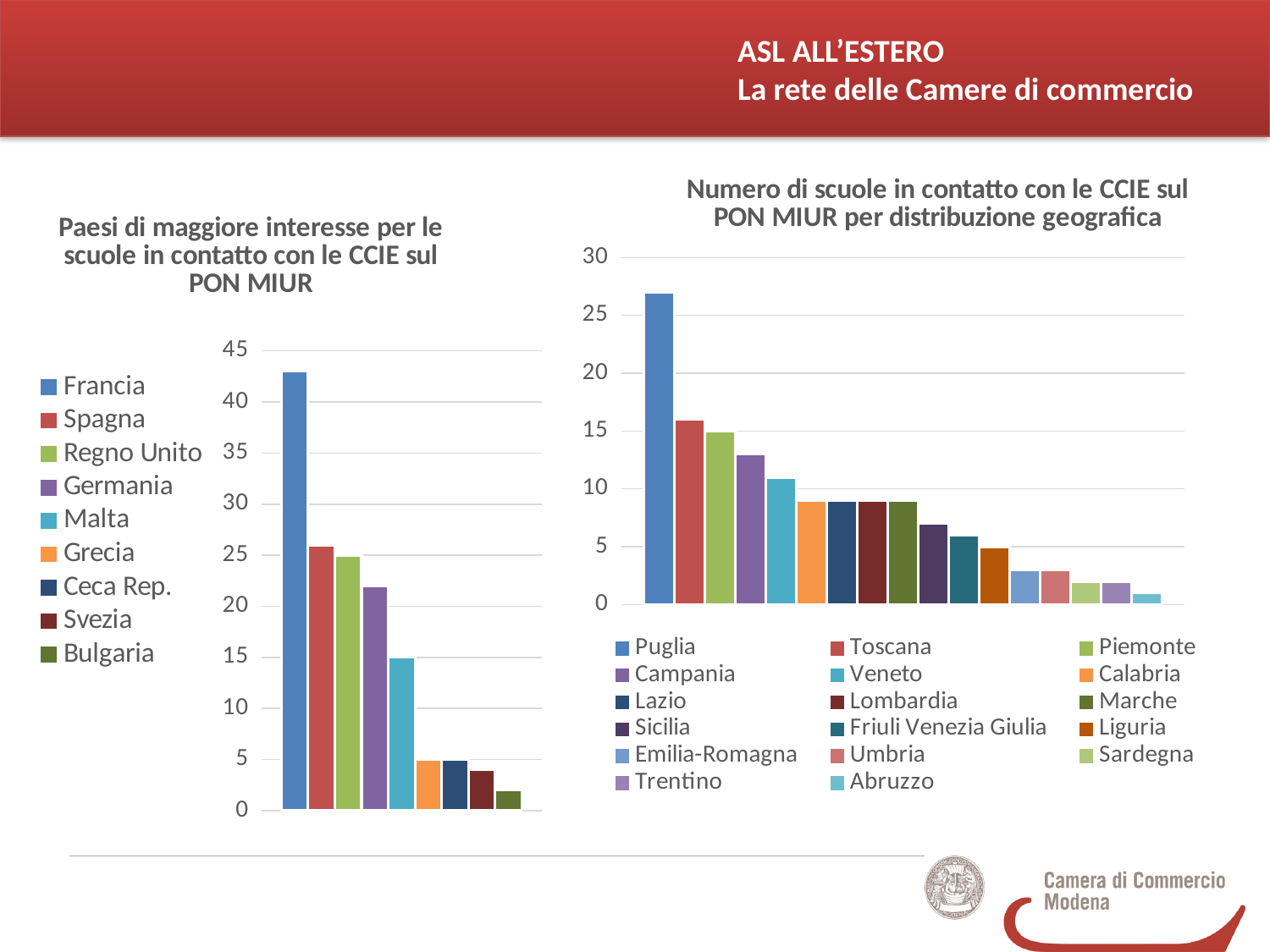
In the left chart, which is larger, the value for Spagna or the value for Germania? Spagna In the chart 'Paesi di maggiore interesse per le scuole in contatto con le CCIE sul PON MIUR', which country has the lowest value? Bulgaria How many regions are listed in the legend of the right chart? 17 In the right chart, which is larger, the value for Toscana or the value for Veneto? Toscana In the chart 'Numero di scuole in contatto con le CCIE sul PON MIUR per distribuzione geografica', which region has the highest value? Puglia In the left chart, is the value for Malta greater or less than 20? less In the chart 'Paesi di maggiore interesse per le scuole in contatto con le CCIE sul PON MIUR', which country has the highest value? Francia In the left chart, is the value for Francia greater or less than 40? greater In the chart 'Numero di scuole in contatto con le CCIE sul PON MIUR per distribuzione geografica', which region has the lowest value? Abruzzo In the right chart, is the value for Puglia greater or less than 25? greater How many countries are listed in the legend of the left chart? 9 What kind of chart is the chart 'Numero di scuole in contatto con le CCIE sul PON MIUR per distribuzione geografica'? bar chart